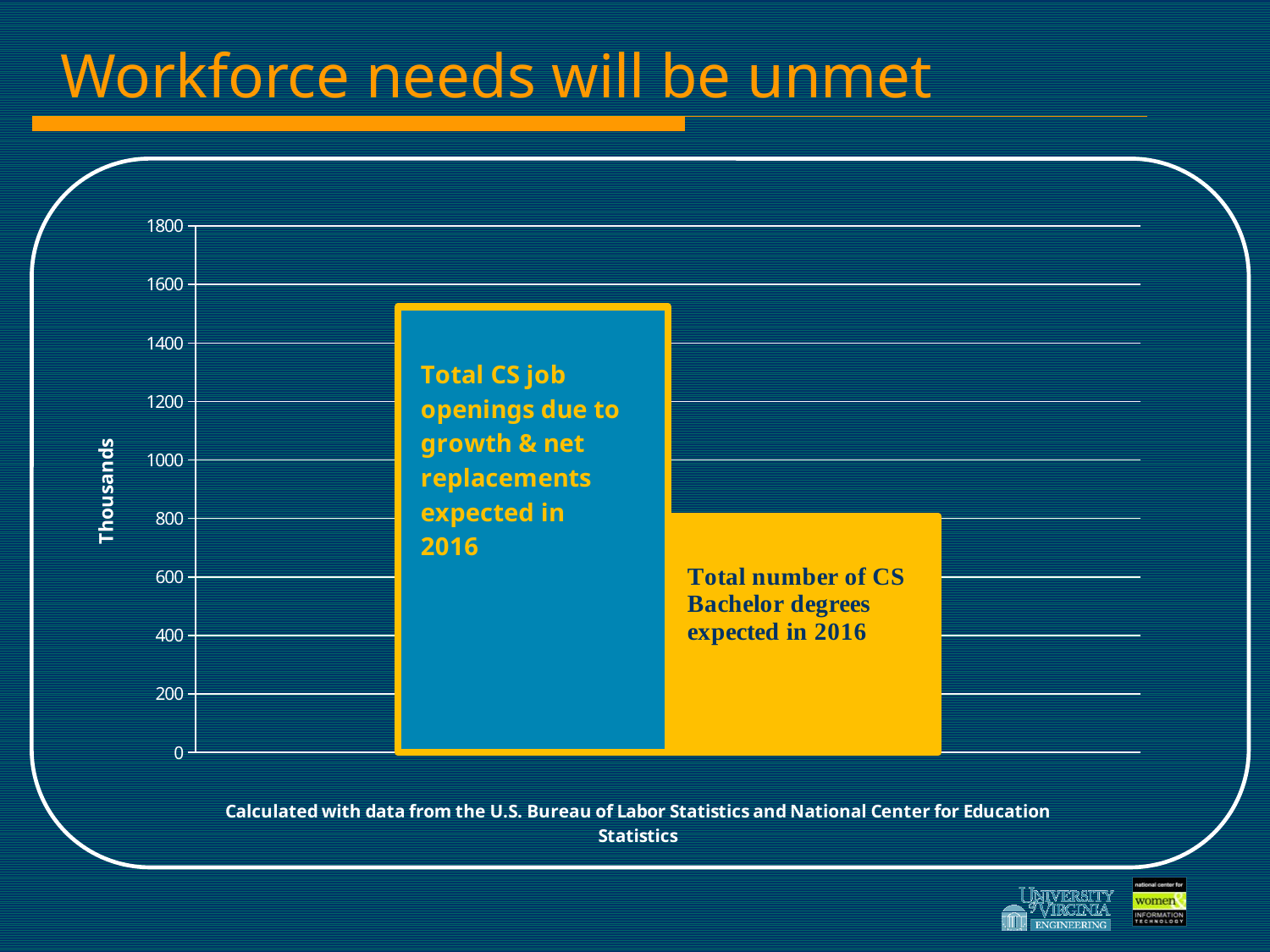
What is the label on the vertical axis of the chart? Thousands Is the value for total CS job openings expected in 2016 greater or less than 1400? greater Which bar is the highest in the chart? Total CS job openings due to growth & net replacements expected in 2016 How many bars are plotted in the chart? 2 What is the title of the slide containing the chart? Workforce needs will be unmet Which is larger: total CS job openings expected in 2016 or total number of CS Bachelor degrees expected in 2016? Total CS job openings expected in 2016 What kind of chart is shown on the slide? bar chart Is the value for total CS job openings expected in 2016 greater or less than 1600? less Which bar is the lowest in the chart? Total number of CS Bachelor degrees expected in 2016 Is the value for total number of CS Bachelor degrees expected in 2016 greater or less than 600? greater